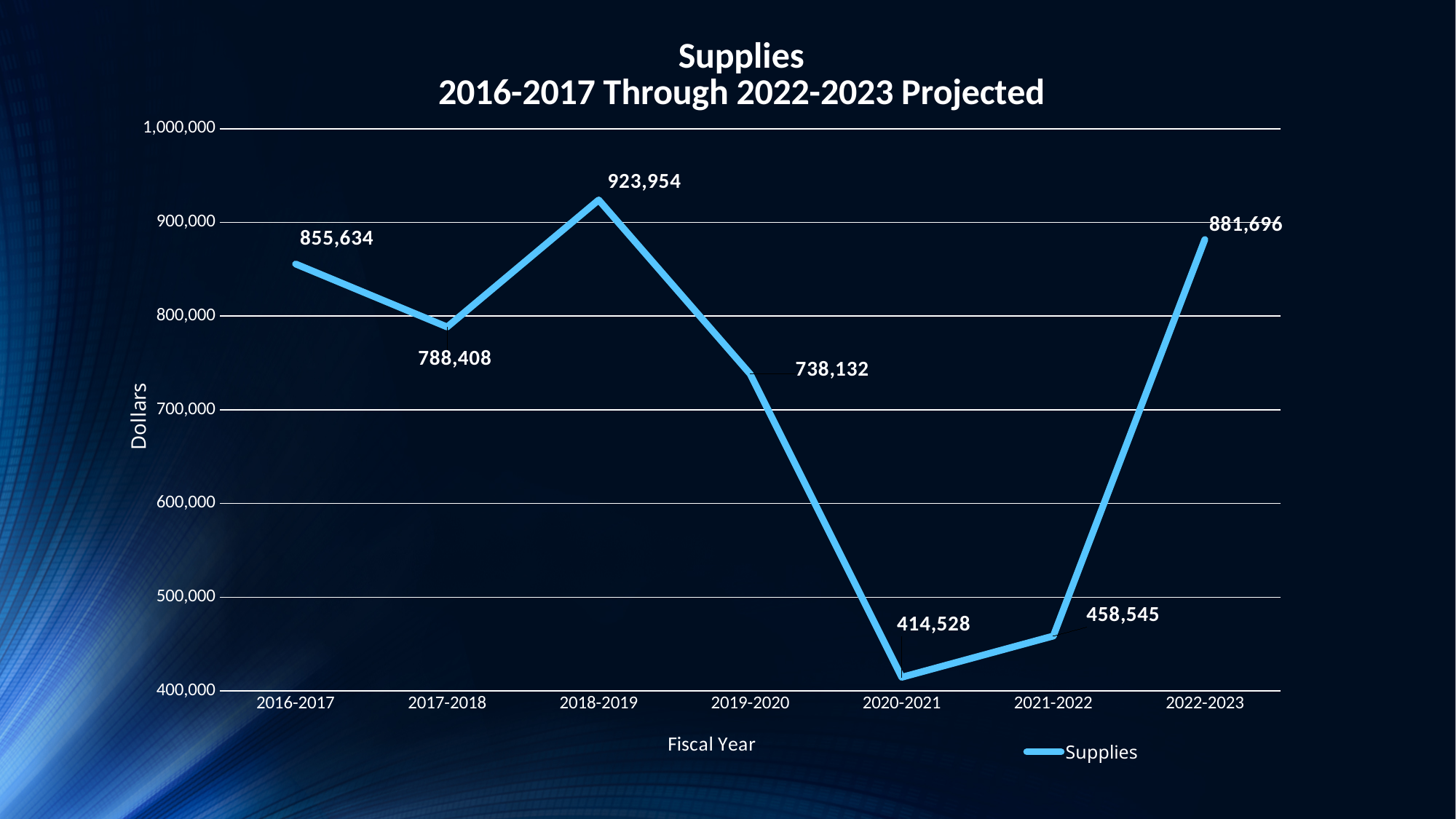
What is the Supplies value for fiscal year 2018-2019? 923,954 Is the Supplies value for 2019-2020 greater or less than 700,000? greater What kind of chart is shown on the slide? Line chart What is the difference between the Supplies values for 2021-2022 and 2020-2021? 44,017 Which fiscal year has the lowest Supplies value? 2020-2021 Which fiscal year has the highest Supplies value? 2018-2019 Which is larger, the Supplies value for 2016-2017 or for 2017-2018? 2016-2017 What is the projected Supplies value for fiscal year 2022-2023? 881,696 What is the label of the y axis? Dollars What is the Supplies value for fiscal year 2020-2021? 414,528 How many fiscal years are plotted on the chart? 7 What is the difference between the Supplies values for 2018-2019 and 2020-2021? 509,426